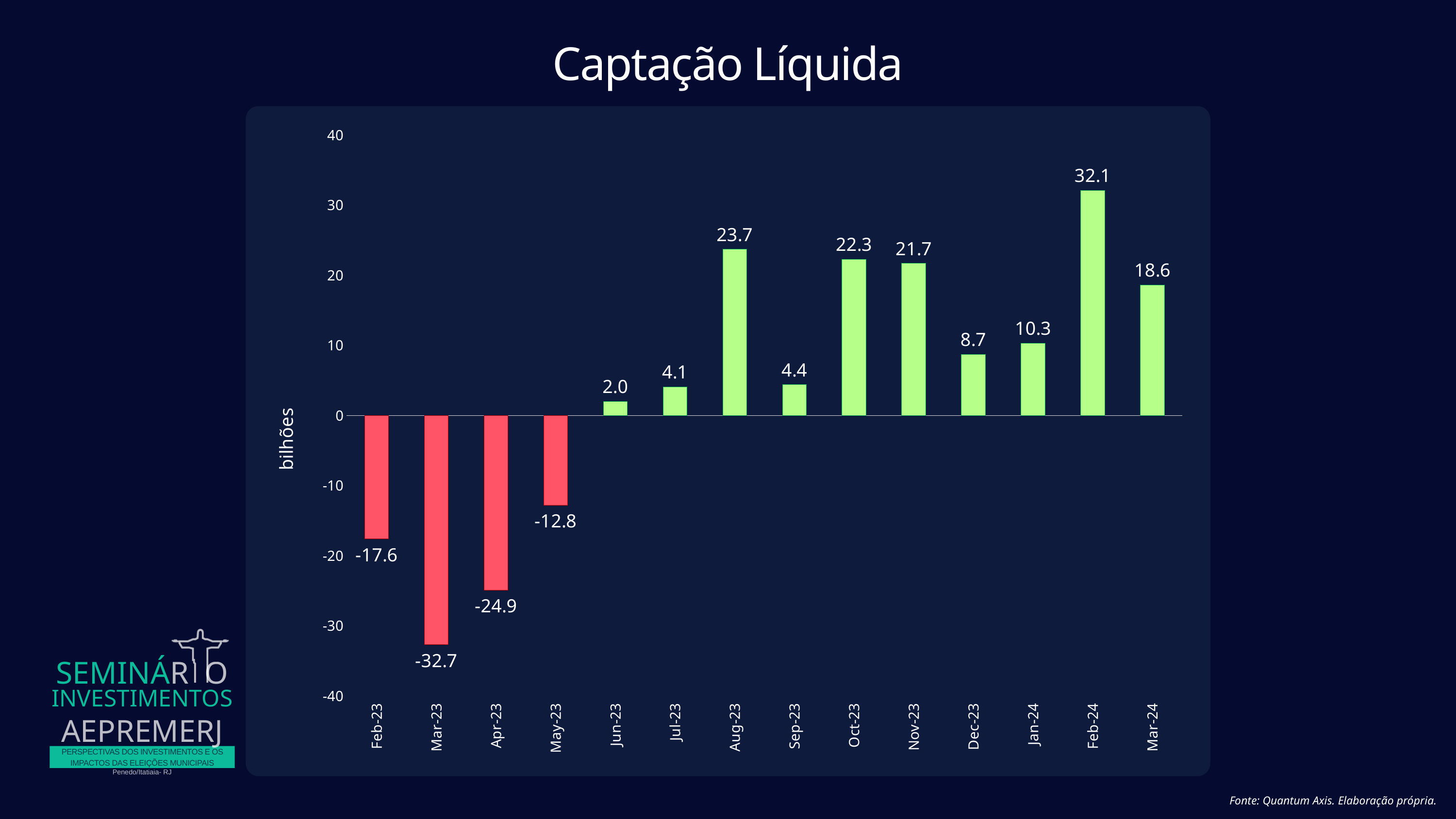
What is the difference between the values for Feb-24 and Mar-24? 13.5 Which month has the lowest value? Mar-23 How many months have negative values? 4 What is the value for Aug-23? 23.7 Which is larger, the value for Oct-23 or the value for Nov-23? Oct-23 What kind of chart is shown? Bar chart How many months are shown on the x axis? 14 What colour are the bars with negative values? Red What is the value for Mar-23? -32.7 What is the value for Feb-24? 32.1 What is the title of the chart? Captação Líquida Which month has the highest value? Feb-24